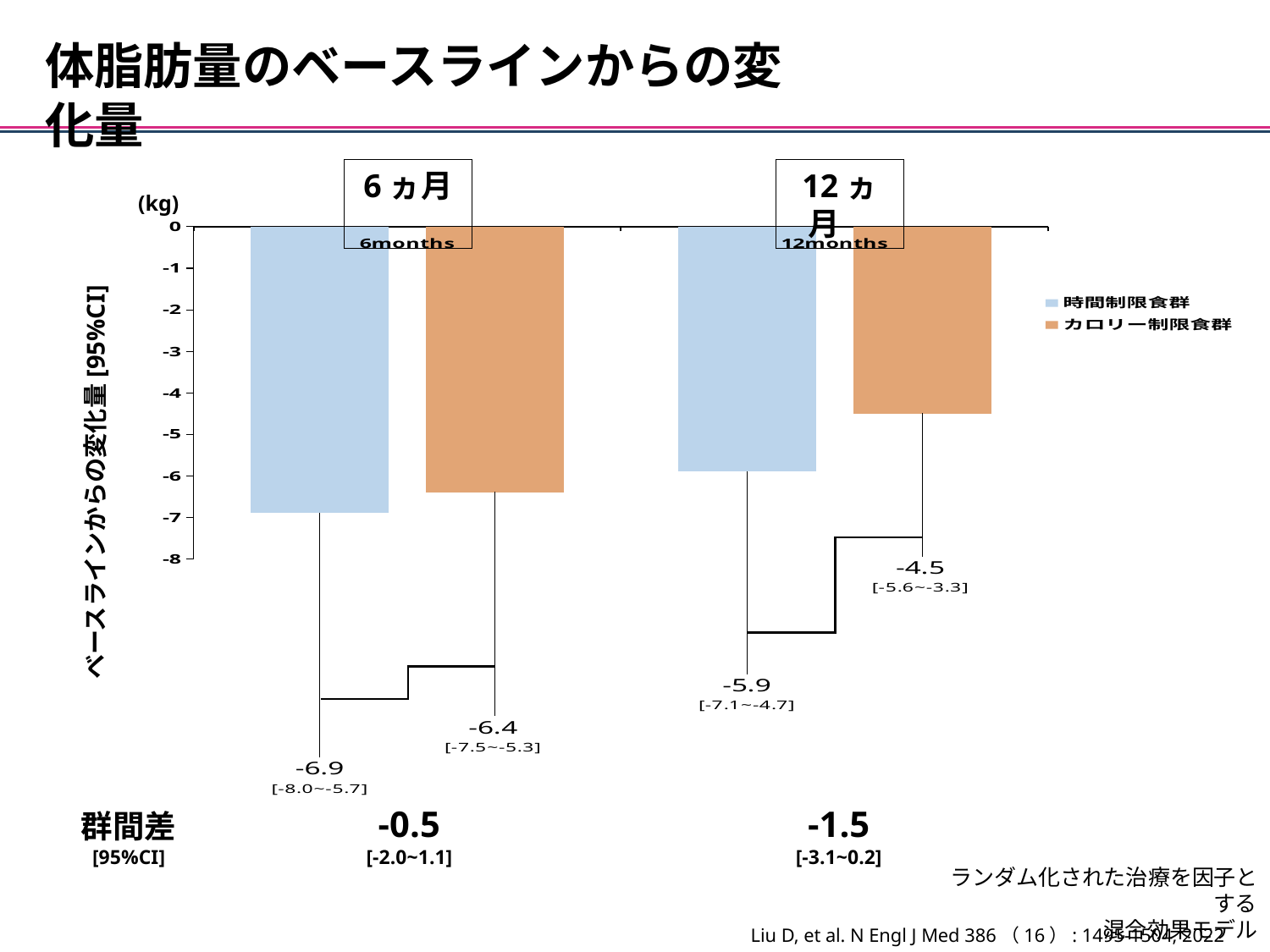
How many series does the legend list? 2 What is the value for the カロリー制限食群 at 12 months? -4.5 What is the difference between the 時間制限食群 and カロリー制限食群 values at 12 months? 1.4 Which bar shows the largest decrease from baseline? 時間制限食群 at 6 months What is the value for the 時間制限食群 at 12 months? -5.9 What is the value for the カロリー制限食群 at 6 months? -6.4 At 6 months, which group has the larger decrease from baseline, 時間制限食群 or カロリー制限食群? 時間制限食群 What kind of chart is shown on the slide? Bar chart What is the value for the 時間制限食群 at 6 months? -6.9 Which bar shows the smallest decrease from baseline? カロリー制限食群 at 12 months How many time-point categories are shown on the x axis? 2 What unit is shown on the y axis of the chart? kg